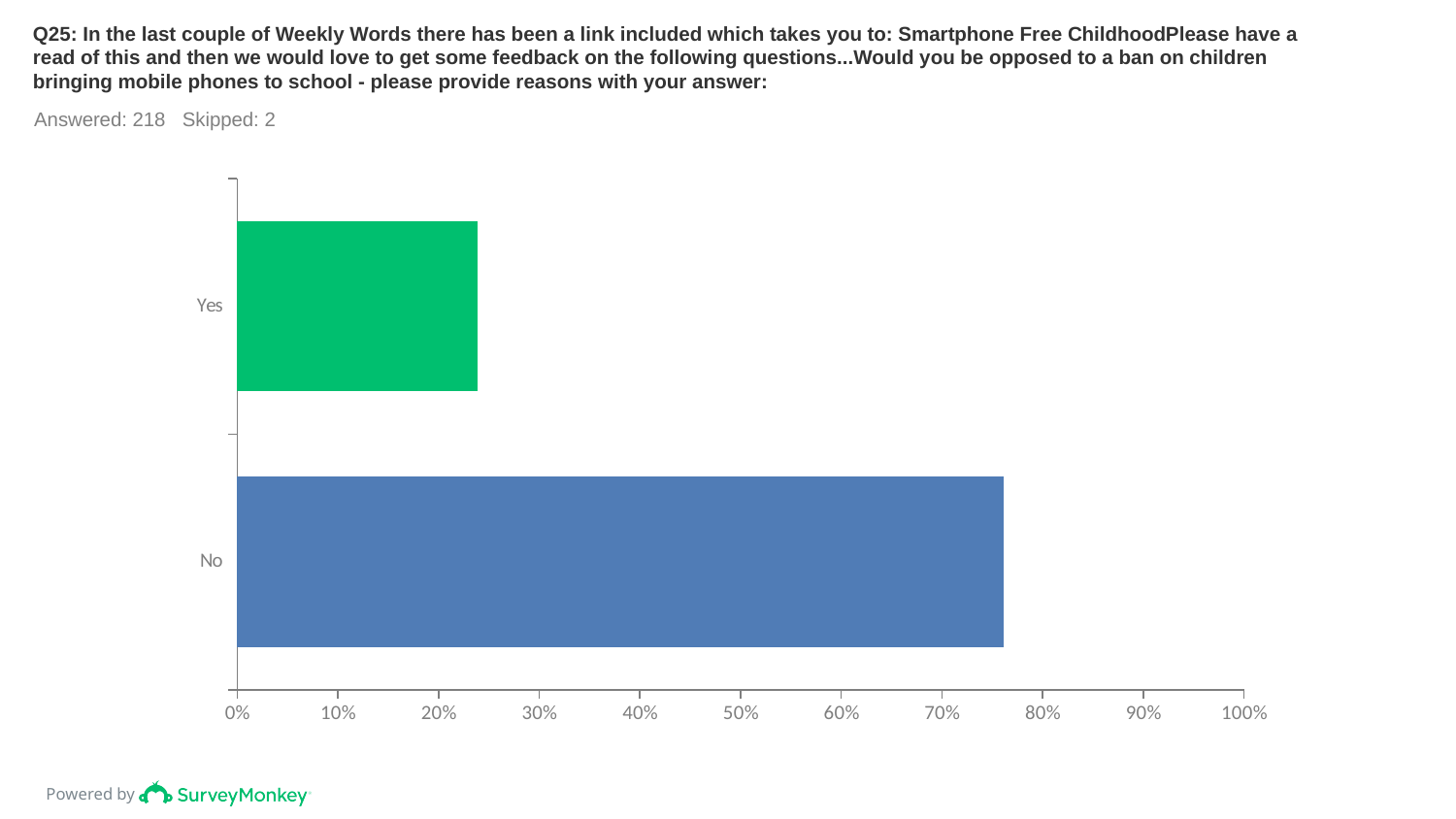
What colour is the bar for Yes? green Which category has the highest value? No How many categories are plotted in the chart? 2 Is the value for No greater or less than 80%? less What is the highest value shown on the x axis? 100% Is the value for No greater or less than 70%? greater Is the value for Yes greater or less than 20%? greater Which is larger, the value for Yes or the value for No? No Which category has the lowest value? Yes What kind of chart is shown on the slide? bar chart